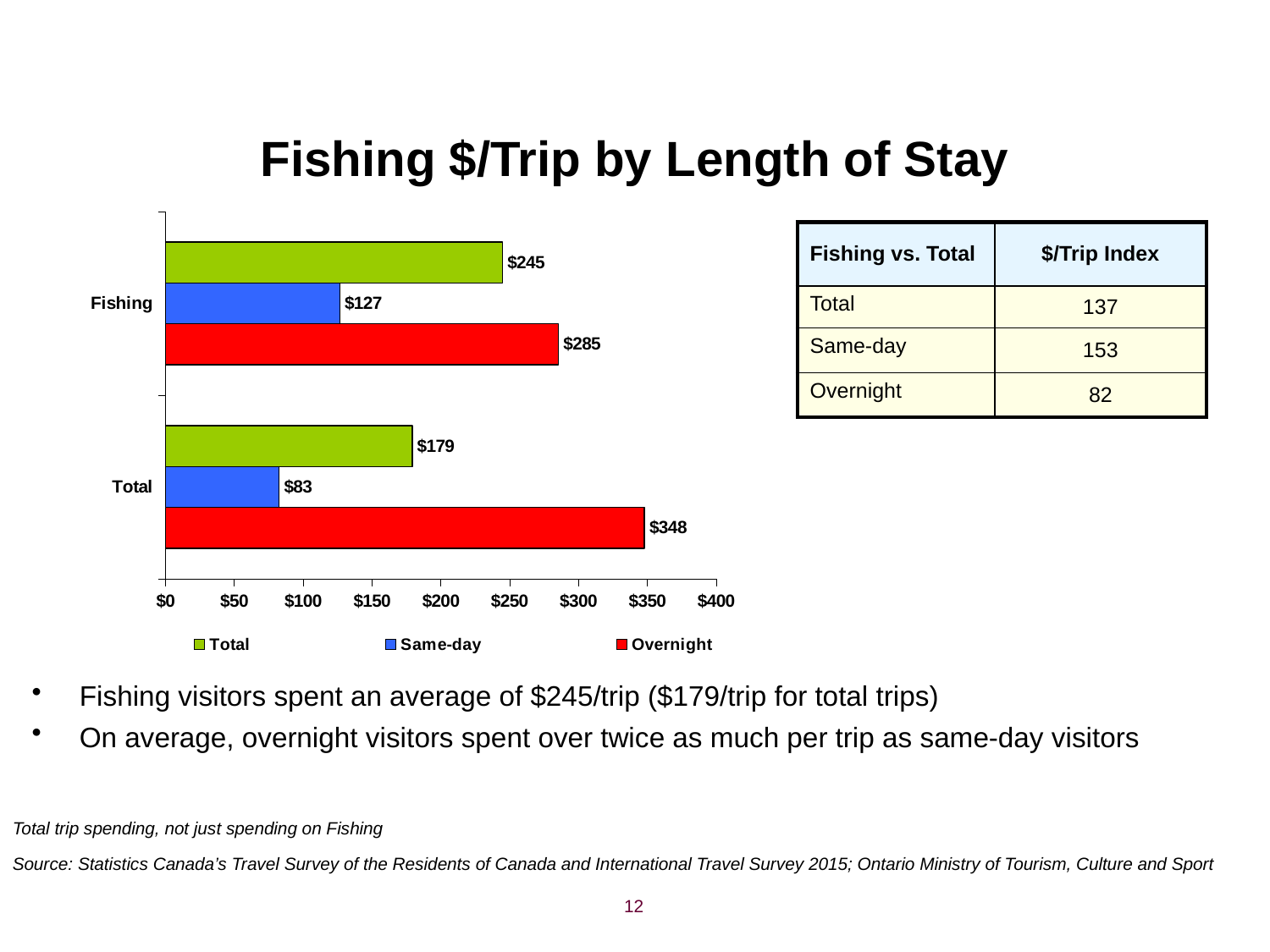
What is the difference between the Overnight values for Total and Fishing? $63 What is the Same-day value for Total? $83 Which series has the lowest value for the Fishing category? Same-day What is the difference between the Same-day values for Fishing and Total? $44 Which is larger, the Total series value for Fishing or the Total series value for Total? Fishing What kind of chart is shown? Bar chart Which series has the highest value for the Total category? Overnight What is the Total series value for Fishing? $245 What colour represents the Overnight series? Red What is the Overnight value for Fishing? $285 How many series does the legend list? 3 How many categories are shown on the y axis? 2